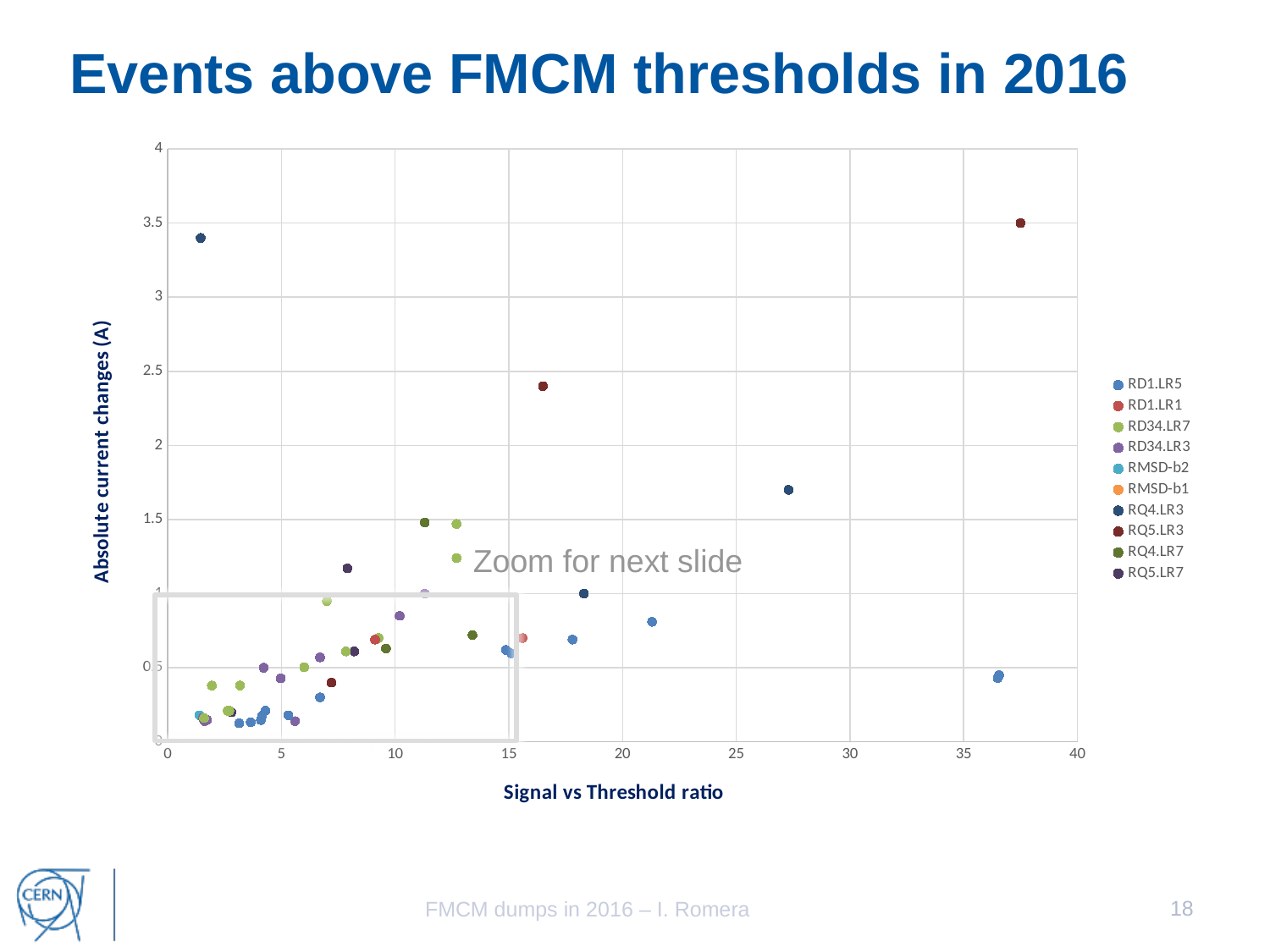
What kind of chart is shown on the slide? scatter chart What is the title of the y axis? Absolute current changes (A) Is the Signal vs Threshold ratio of the point plotted near 3.4 A greater or less than 5? less Is the absolute current change of the RQ4.LR3 point plotted near a ratio of 27 greater or less than 2? less Which has the larger absolute current change: the point plotted near a ratio of 37 or the point plotted near a ratio of 27? the point near a ratio of 37 Which has the larger Signal vs Threshold ratio: the point plotted near 3.4 A or the point plotted near 3.5 A? the point near 3.5 A Is the absolute current change of the RD1.LR5 point plotted near a ratio of 36 greater or less than 1? less What is the title of the x axis? Signal vs Threshold ratio How many series does the legend list? 10